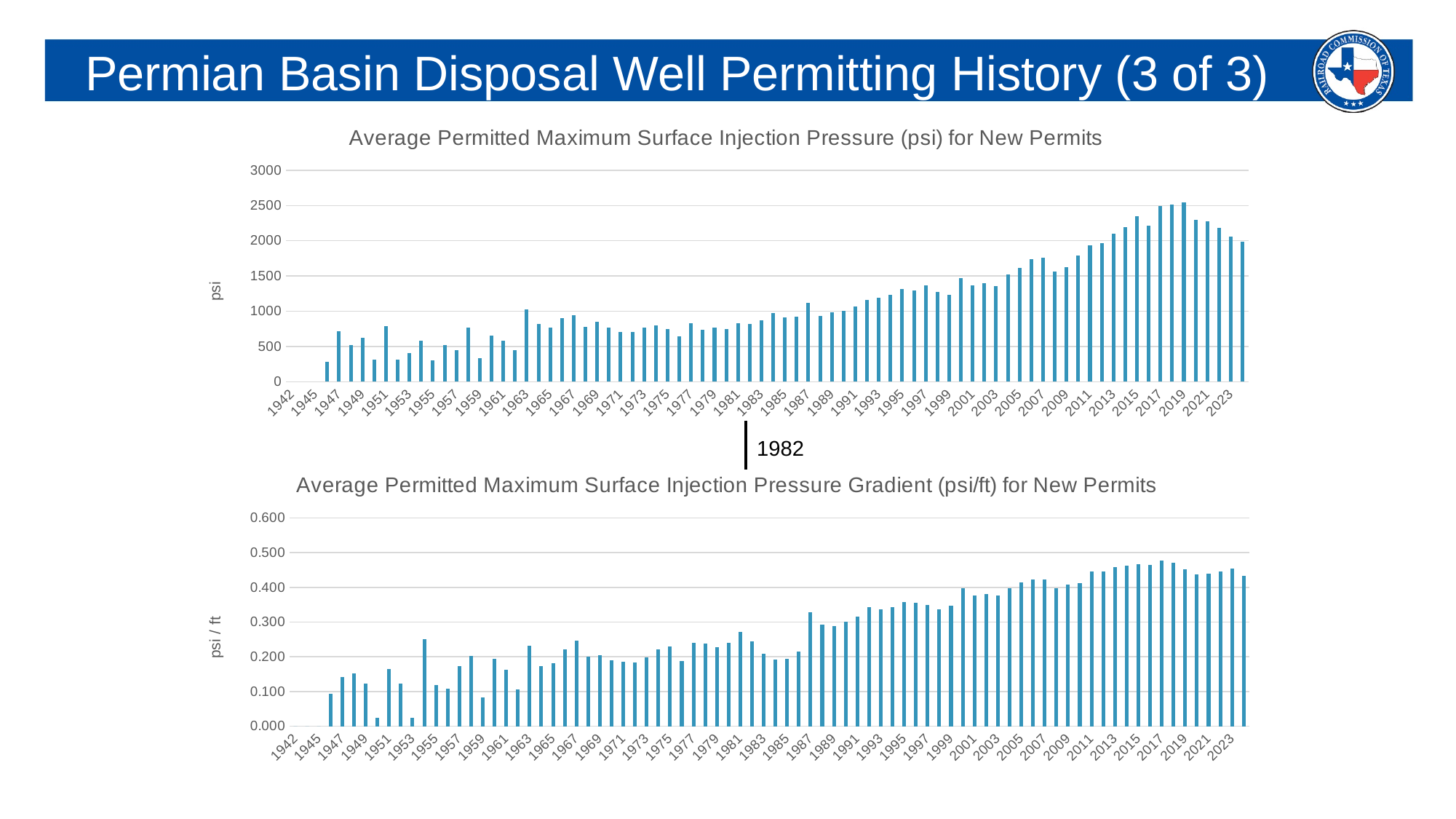
In the top chart (psi), is the value for 2023 greater or less than 2500? less In the bottom chart (psi/ft), is the value for 1945 greater or less than 0.100? less In the bottom chart (psi/ft), is the value for 2017 greater or less than 0.400? greater How many charts are shown on the slide? 2 What kind of chart is the top chart, 'Average Permitted Maximum Surface Injection Pressure (psi) for New Permits'? Bar chart What is the y-axis label of the bottom chart? psi / ft In the top chart (psi), do the values generally rise or fall from the 1940s to the 2020s? Rise In the bottom chart (psi/ft), which year has the larger value, 2013 or 1963? 2013 In the top chart (psi), which year has the larger value, 2019 or 1963? 2019